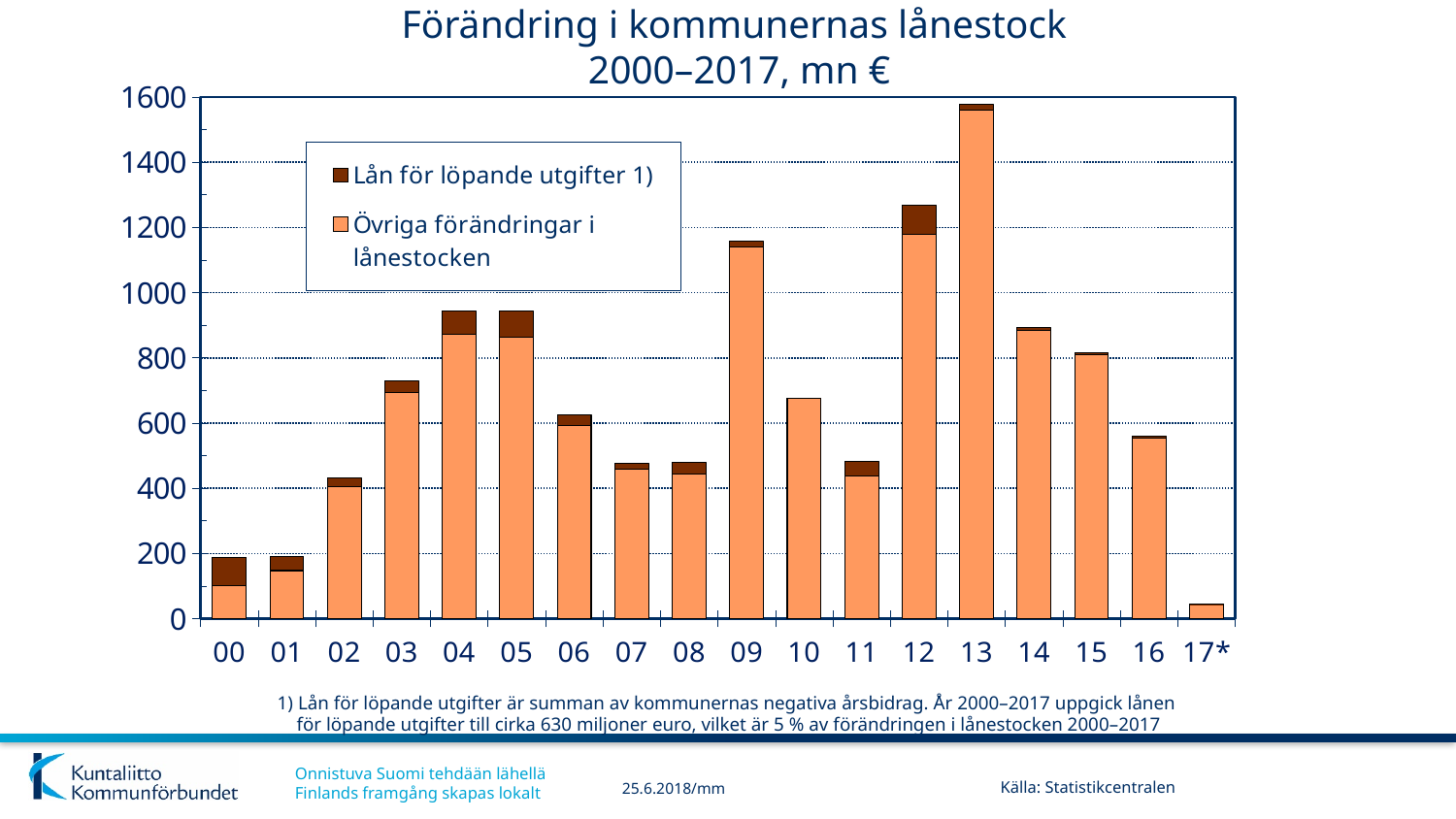
Which year has the lowest total change in the loan stock? 17* Is the total value for 16 greater or less than 600? less Which year has the highest total change in the loan stock? 13 What is the title of the chart? Förändring i kommunernas lånestock 2000–2017, mn € Is the total value for 09 greater or less than 1000? greater Is the total value for 13 greater or less than 1400? greater How many series does the legend list? 2 Which year has the larger total bar, 09 or 10? 09 Do the total values rise or fall from 13 to 17*? Fall What kind of chart is shown on the slide? Stacked bar chart How many years (bars) are shown on the x axis? 18